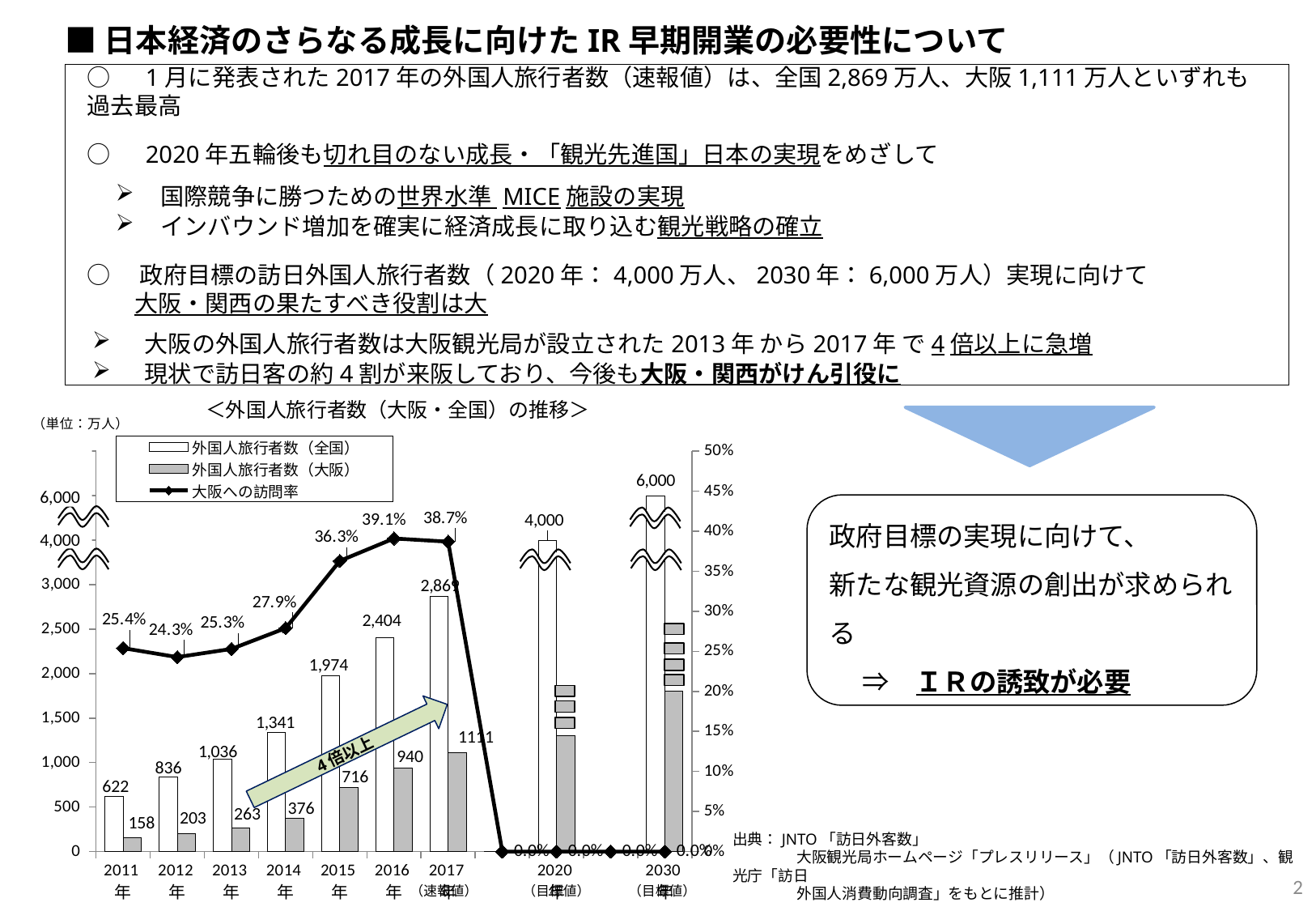
In the chart ＜外国人旅行者数（大阪・全国）の推移＞, what is the 目標値 for 外国人旅行者数（全国） in 2020年? 4,000 In the chart ＜外国人旅行者数（大阪・全国）の推移＞, what is the value of 外国人旅行者数（全国） for 2016年? 2,404 What kind of chart is ＜外国人旅行者数（大阪・全国）の推移＞? Bar chart with a line In the chart ＜外国人旅行者数（大阪・全国）の推移＞, which year from 2011 to 2017 has the lowest 大阪への訪問率? 2012年 How many series does the legend of the chart ＜外国人旅行者数（大阪・全国）の推移＞ list? 3 In the chart ＜外国人旅行者数（大阪・全国）の推移＞, what is the difference between 外国人旅行者数（大阪） in 2017年 and in 2011年? 953 In the chart ＜外国人旅行者数（大阪・全国）の推移＞, what is the 大阪への訪問率 for 2014年? 27.9% In the chart ＜外国人旅行者数（大阪・全国）の推移＞, which is larger: 外国人旅行者数（大阪） in 2013年 or in 2014年? 2014年 In the chart ＜外国人旅行者数（大阪・全国）の推移＞, by how much did 外国人旅行者数（全国） increase from 2015年 to 2016年? 430 In the chart ＜外国人旅行者数（大阪・全国）の推移＞, does 外国人旅行者数（全国） rise or fall from 2011年 to 2017年? Rise In the chart ＜外国人旅行者数（大阪・全国）の推移＞, which year from 2011 to 2017 has the highest 大阪への訪問率? 2016年 In the chart ＜外国人旅行者数（大阪・全国）の推移＞, what is the value of 外国人旅行者数（大阪） for 2015年? 716